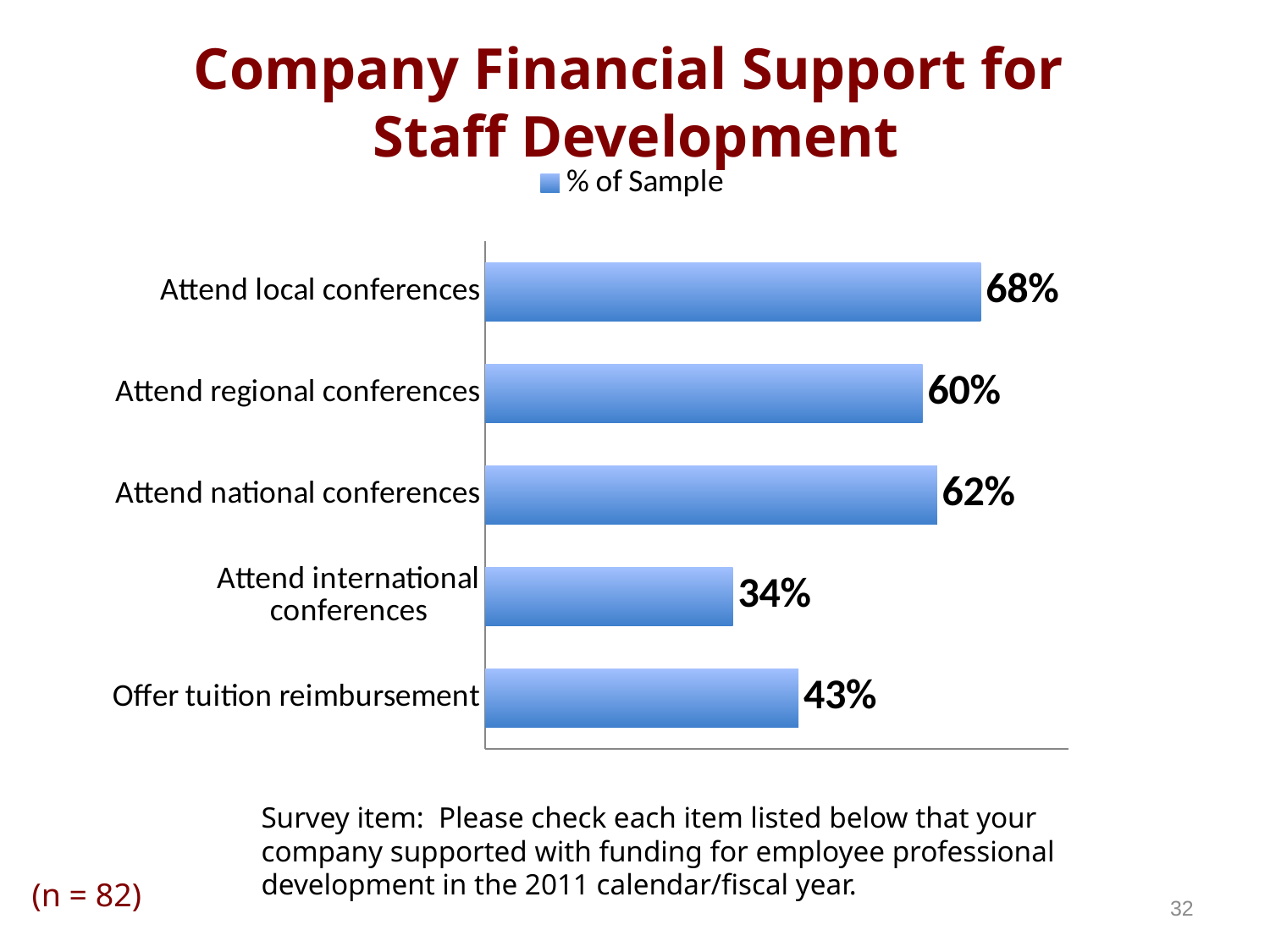
What percentage of the sample reported company support for attending local conferences? 68% What is the difference between the values for attending local conferences and attending international conferences? 34% What is the difference between the values for attending national conferences and attending regional conferences? 2% Which category has the highest value in the chart? Attend local conferences How many categories are shown in the chart? 5 Which category has the lowest value in the chart? Attend international conferences What is the name of the series shown in the legend? % of Sample How many series does the legend list? 1 What kind of chart is shown on the slide? Bar chart Which is larger: the value for attending national conferences or the value for offering tuition reimbursement? Attend national conferences What percentage is shown for attending international conferences? 34% What is the value shown for 'Offer tuition reimbursement'? 43%